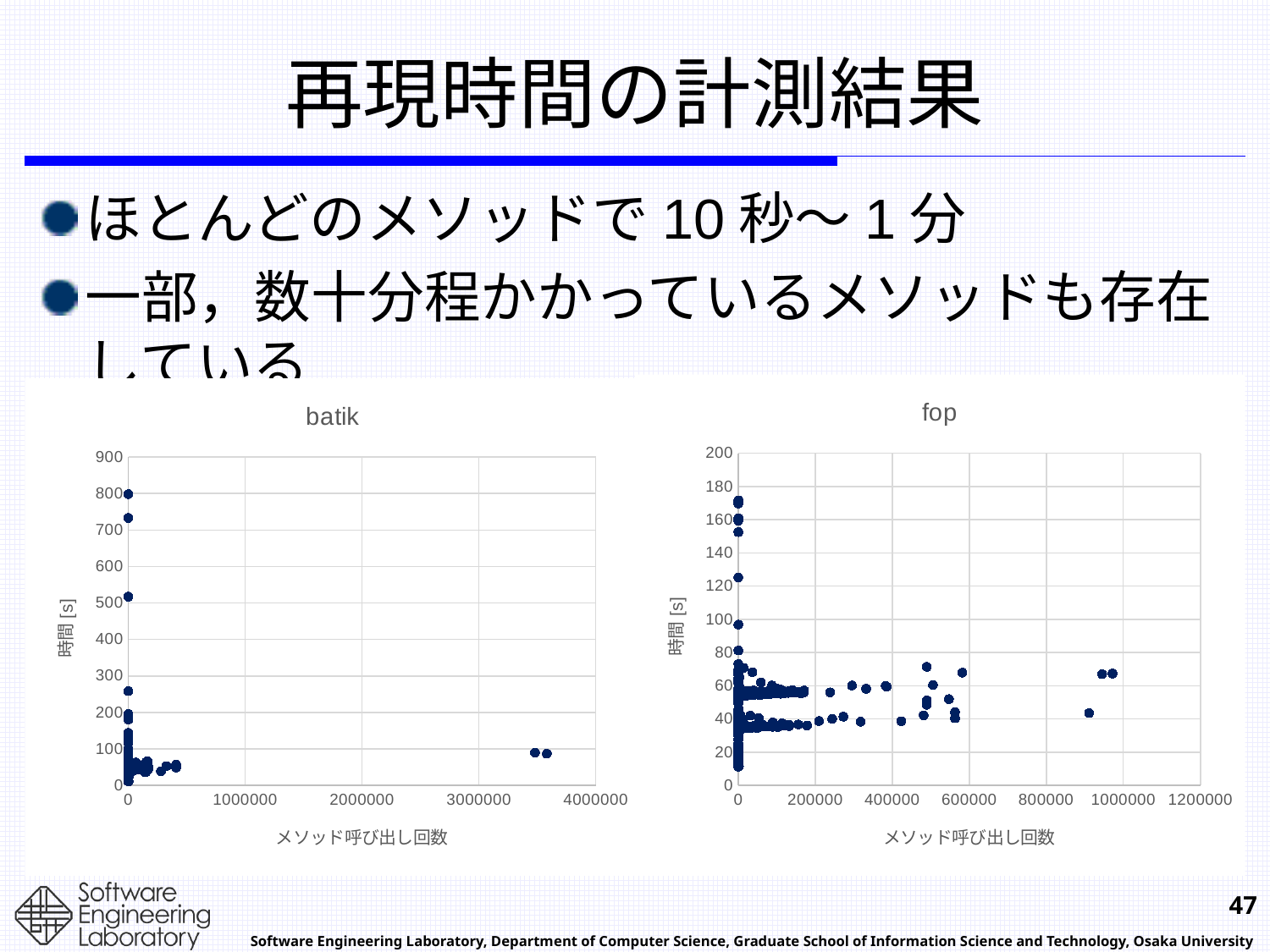
How many charts are shown on the slide? 2 In the "batik" chart, is the highest plotted time value greater or less than 700? greater What is the title of the chart on the right side of the slide? fop What is the title of the chart on the left side of the slide? batik In the "fop" chart, is the highest plotted time value greater or less than 150? greater In the "fop" chart, are the time values of the points near 1000000 method calls greater or less than 100? less In the "batik" chart, what is the highest value shown on the y axis? 900 What kind of chart is the "batik" chart? scatter chart What kind of chart is the "fop" chart? scatter chart